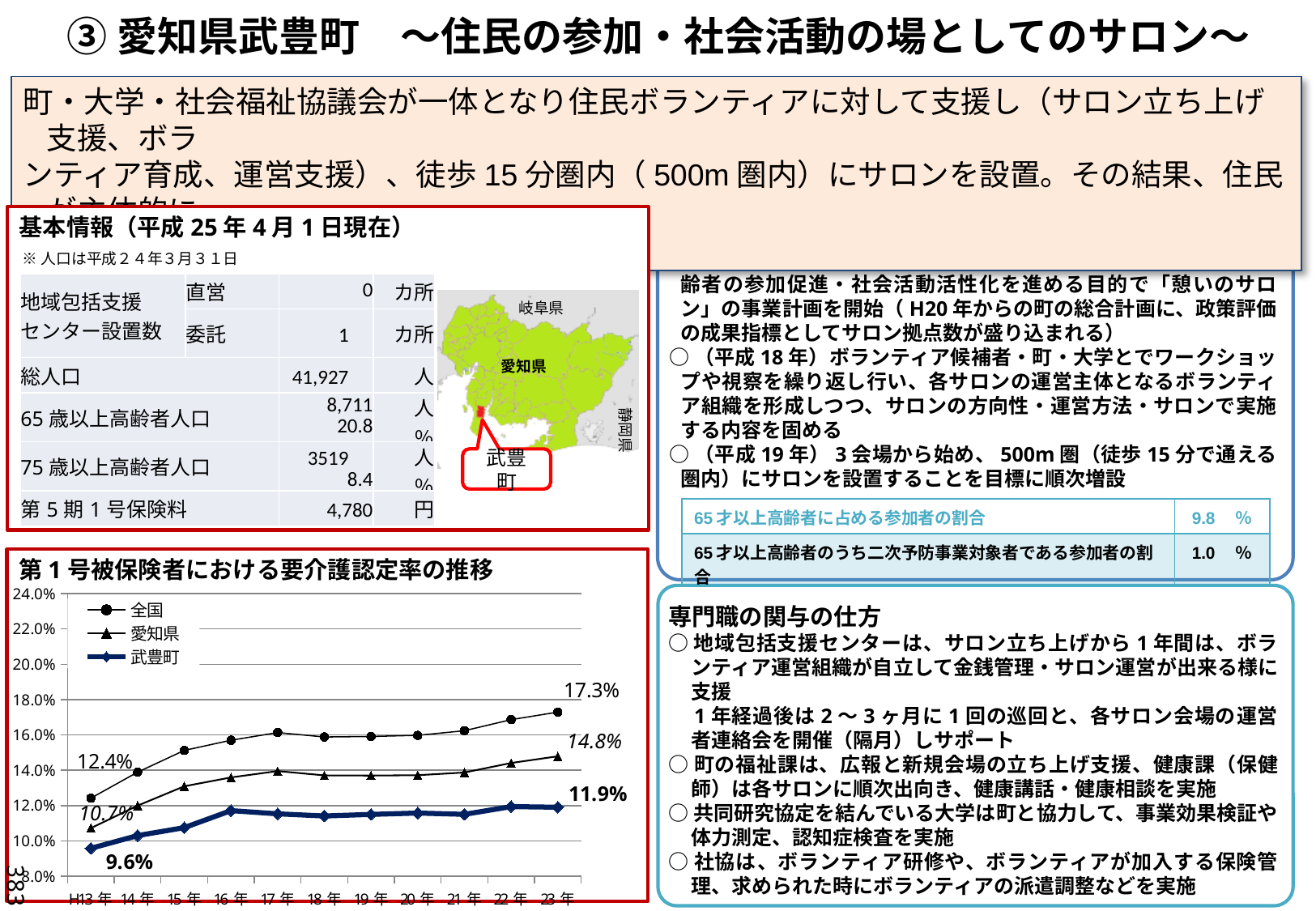
In the line chart, what is the value for 武豊町 in H13年? 9.6% In the line chart, what is the value for 武豊町 in 23年? 11.9% How many years are plotted along the x axis of the line chart? 11 In the line chart, what is the difference between the 全国 and 武豊町 values in 23年? 5.4% Which series are listed in the legend of the line chart? 全国, 愛知県, 武豊町 What kind of chart is shown under the title 第1号被保険者における要介護認定率の推移? line chart How many series does the legend of the line chart list? 3 In the line chart, which series has the highest value in 23年? 全国 In the line chart, does the 武豊町 series rise or fall from H13年 to 23年? rise In the line chart, what is the value for 全国 in H13年? 12.4% In the line chart, what is the value for 全国 in 23年? 17.3% In the line chart, what is the value for 愛知県 in 23年? 14.8%